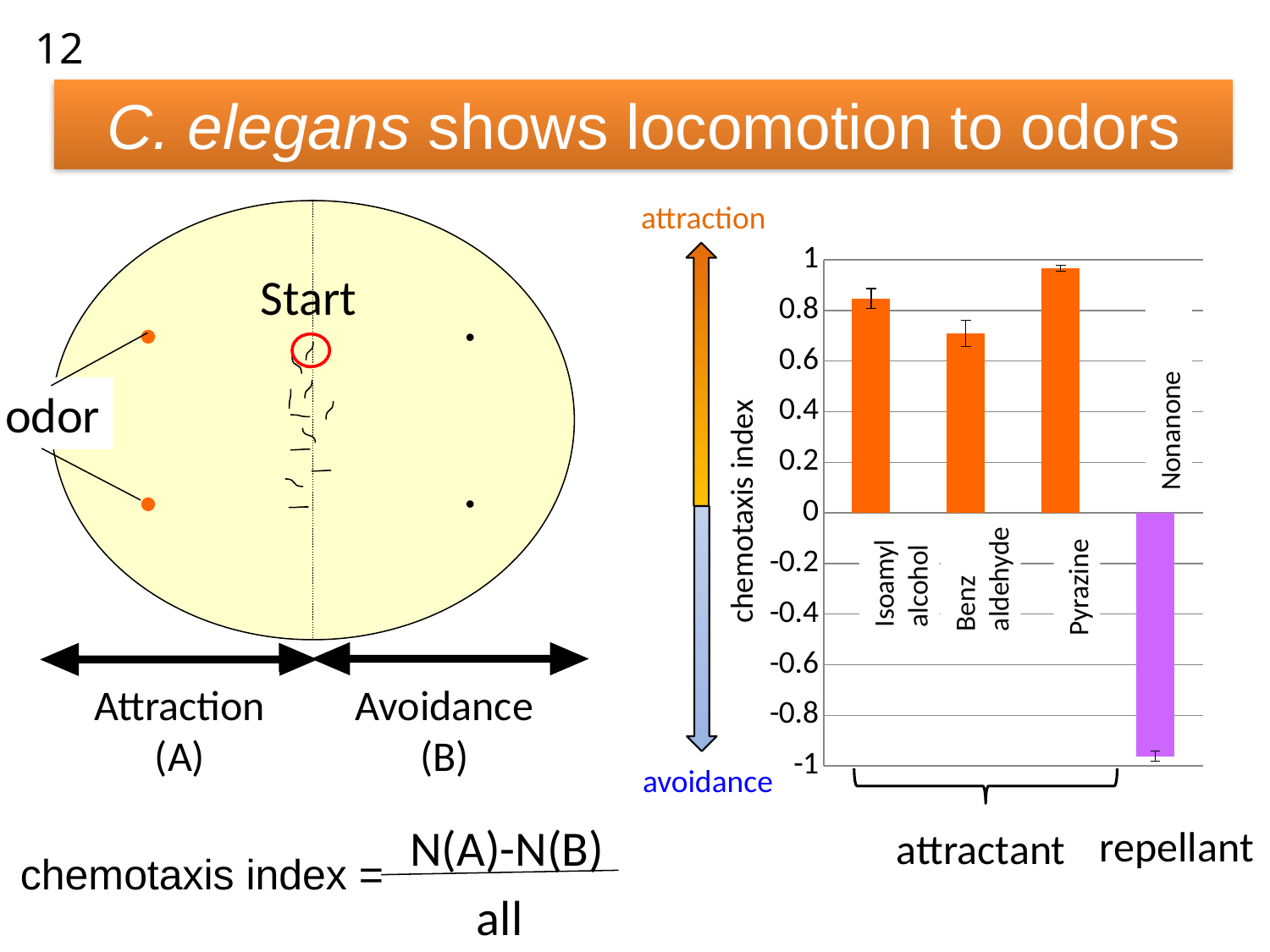
What is the label of the vertical axis of the chart? chemotaxis index Is the chemotaxis index for Benz aldehyde greater or less than 0.8? less Is the chemotaxis index for Pyrazine greater or less than 0.8? greater Is the chemotaxis index for Isoamyl alcohol greater or less than 0.8? greater Which has a higher chemotaxis index, Isoamyl alcohol or Benz aldehyde? Isoamyl alcohol Which odor has the highest chemotaxis index in the chart? Pyrazine Which odor has the lowest chemotaxis index in the chart? Nonanone What kind of chart is shown on the slide? bar chart How many odors (bars) are plotted in the chart? 4 How many odors in the chart have a positive chemotaxis index? 3 Which odor's bar is drawn in purple rather than orange? Nonanone